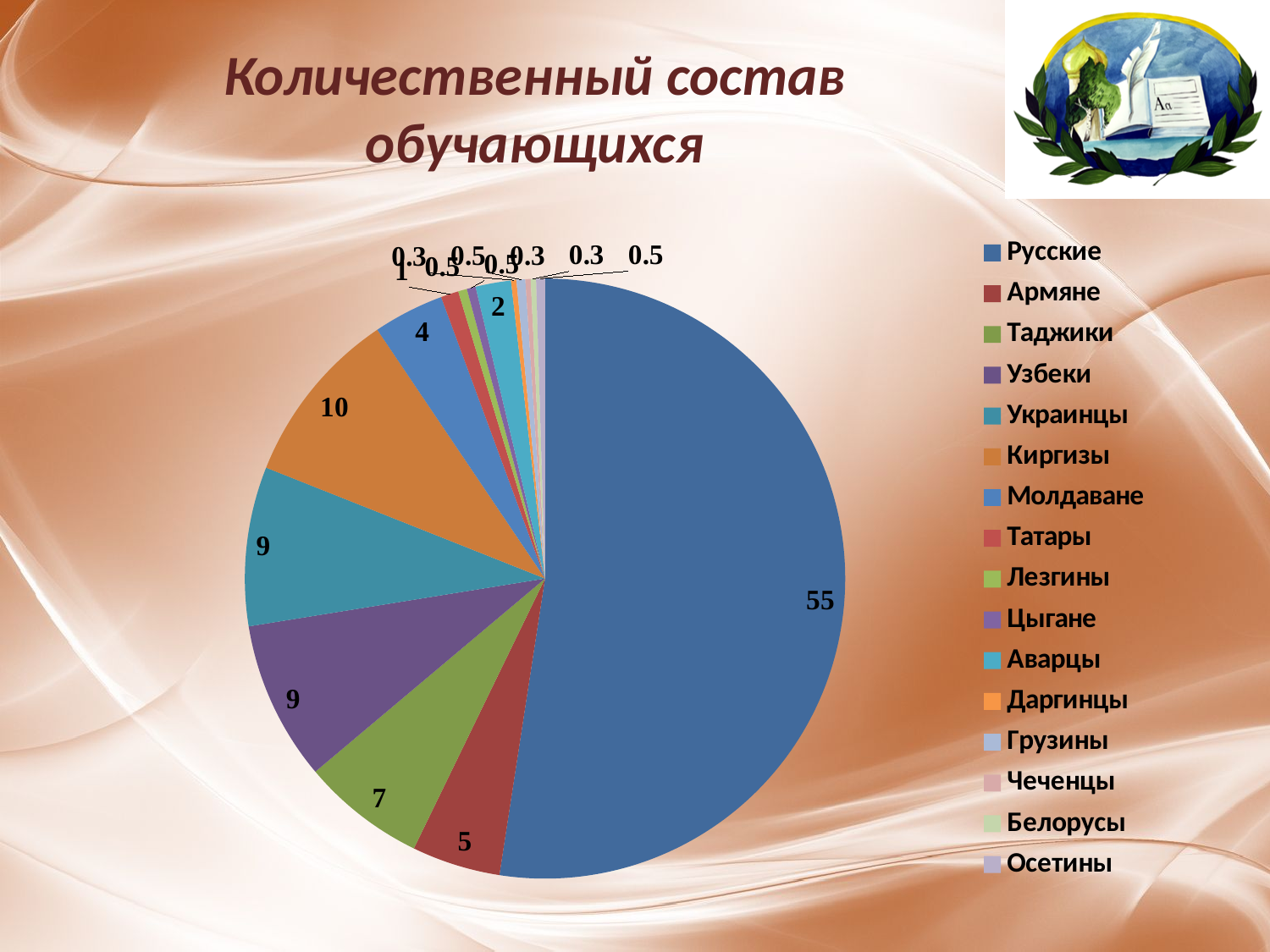
What is the value for Таджики in the pie chart? 7 What is the value for Русские in the pie chart? 55 Which category has the largest slice in the pie chart? Русские Which is larger, the value for Таджики or the value for Армяне? Таджики What is the difference between the values for Русские and Киргизы? 45 What is the value for Киргизы in the pie chart? 10 What is the difference between the values for Киргизы and Молдаване? 6 What kind of chart is shown on the slide? pie chart How many categories does the legend of the pie chart list? 16 What is the value for Армяне in the pie chart? 5 What is the value for Молдаване in the pie chart? 4 What is the title of the slide containing the pie chart? Количественный состав обучающихся